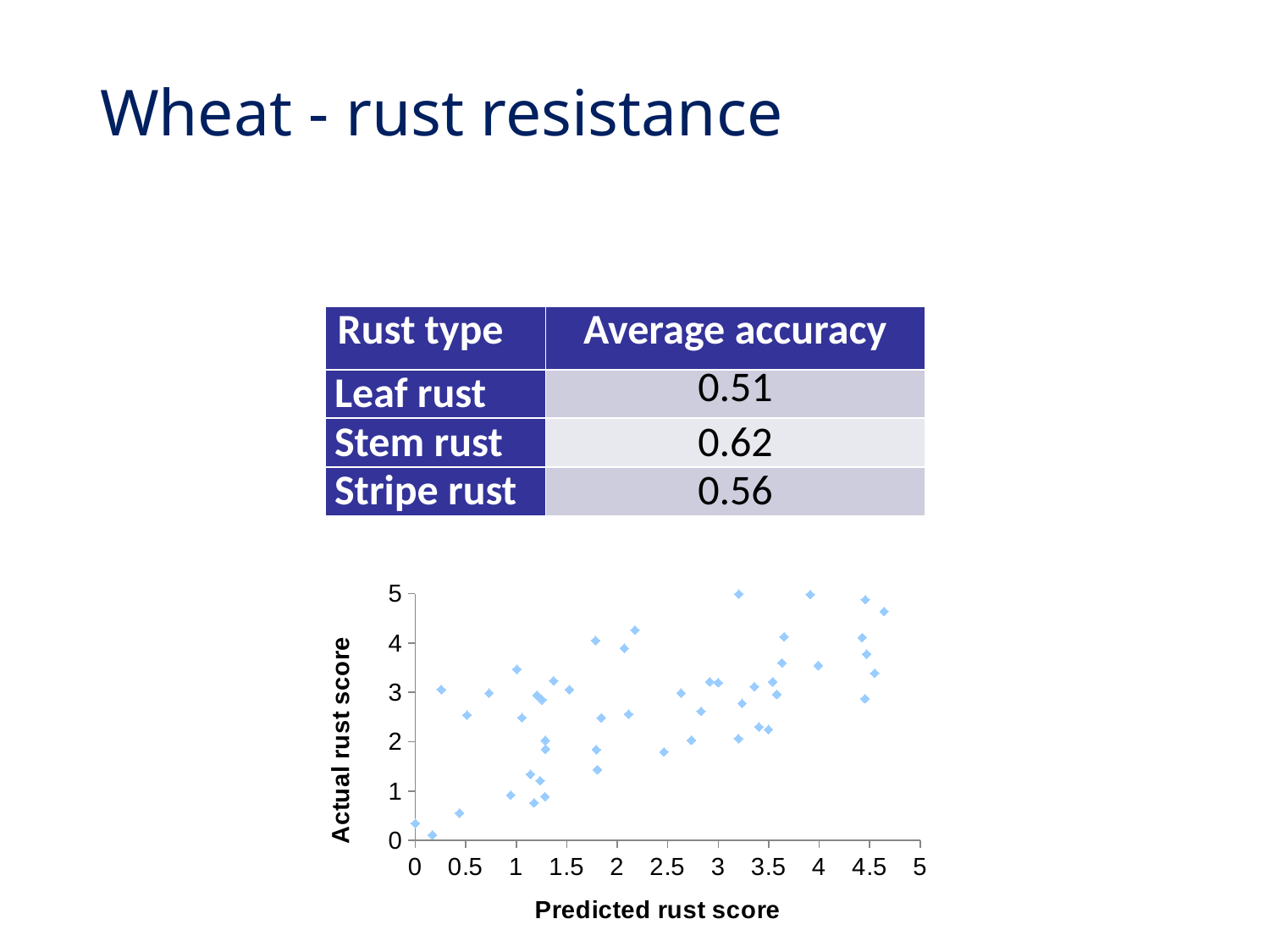
Is the actual rust score of the point with the highest predicted rust score greater or less than 4? greater What kind of chart is shown on the slide? scatter chart What is the title of the y axis of the scatter chart? Actual rust score What is the title of the x axis of the scatter chart? Predicted rust score Do the actual rust scores generally rise or fall as the predicted rust score increases along the x axis? rise Is the actual rust score of the point with the lowest predicted rust score greater or less than 1? less